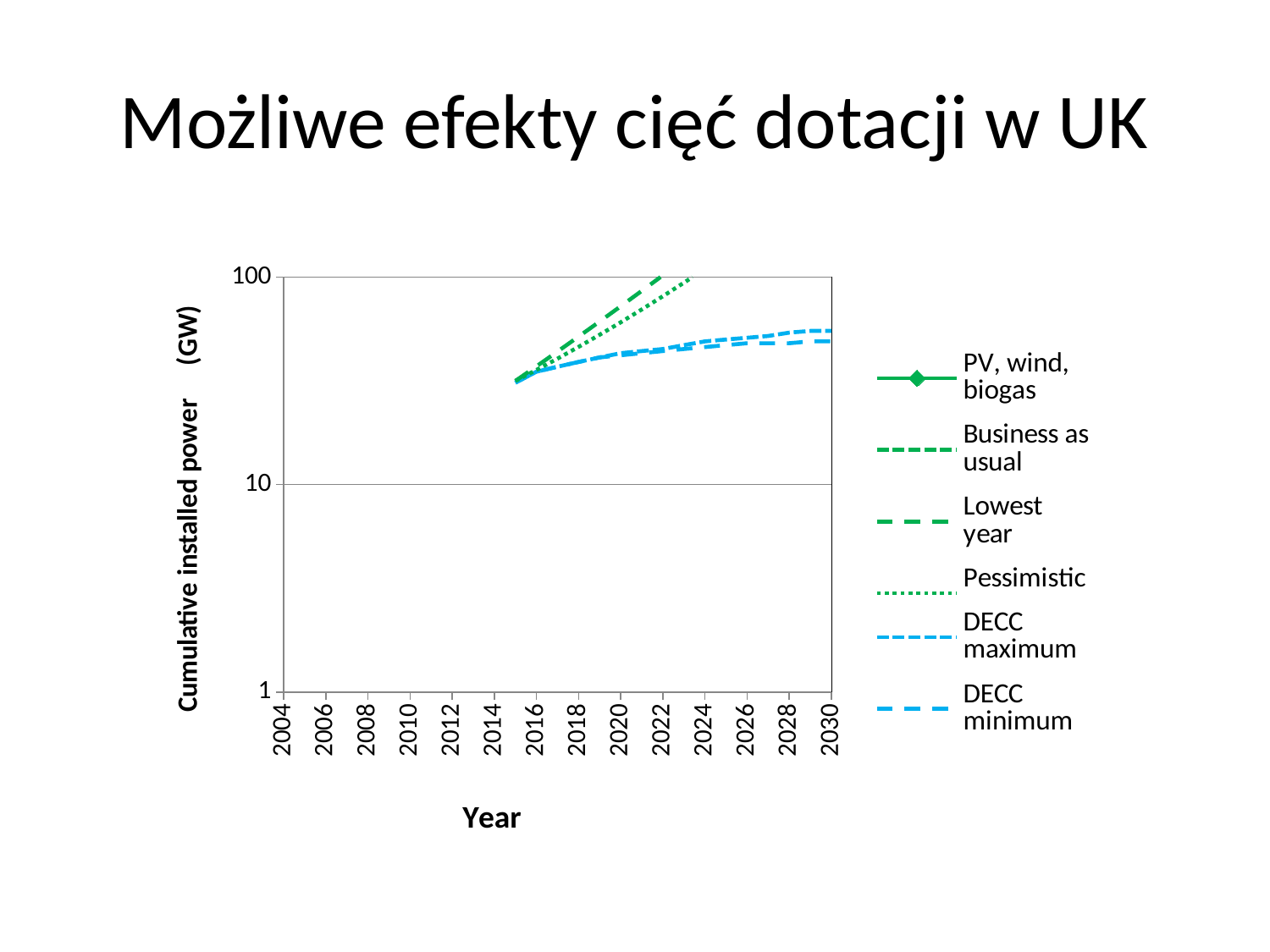
Is the value of the DECC minimum series in 2030 greater or less than 10? greater What is the last year shown on the horizontal axis? 2030 What is the first year shown on the horizontal axis? 2004 Is the value of the DECC maximum series in 2030 greater or less than 100? less What is the title of the chart's vertical axis? Cumulative installed power (GW) Which series reaches 100 GW first, Lowest year or DECC maximum? Lowest year Is the value of the Lowest year series in 2020 greater or less than 10? greater In 2022, which is larger, the Lowest year series or the DECC minimum series? Lowest year Do the plotted series rise or fall as the year increases? rise What kind of chart is shown on the slide? line chart How many series does the chart legend list? 6 What is the title of the chart's horizontal axis? Year